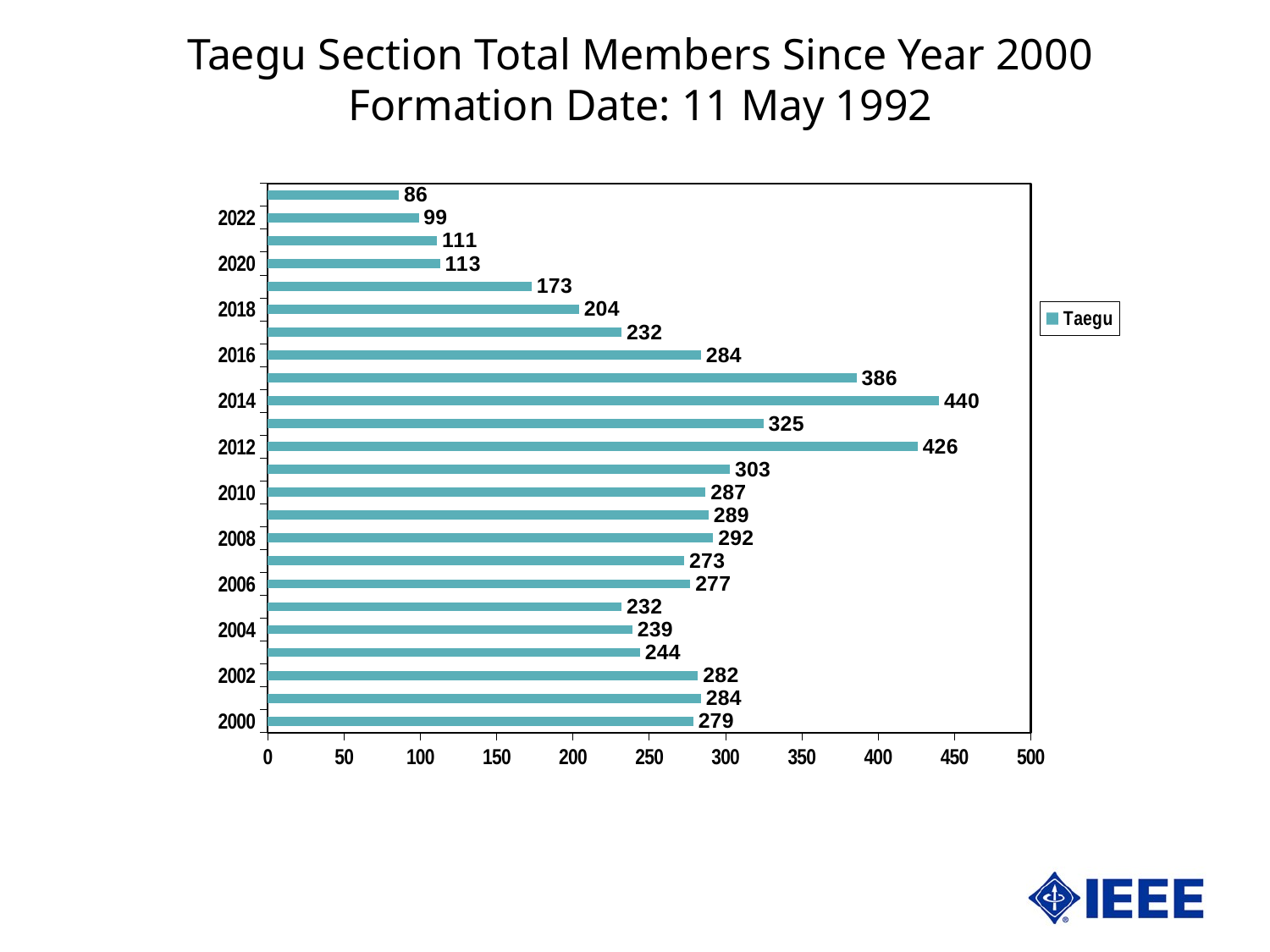
What is the value for 2022? 99 Which is larger, the value for 2008 or the value for 2010? 2008 What is the difference between the values for 2014 and 2012? 14 What is the difference between the values for 2000 and 2022? 180 What is the value for 2014? 440 What is the value for 2000? 279 What is the smallest value labeled on the chart? 86 What kind of chart is shown on the slide? Bar chart Which year has the highest value? 2014 How many series does the legend list? 1 What is the value for 2018? 204 How many bars are plotted on the chart? 24